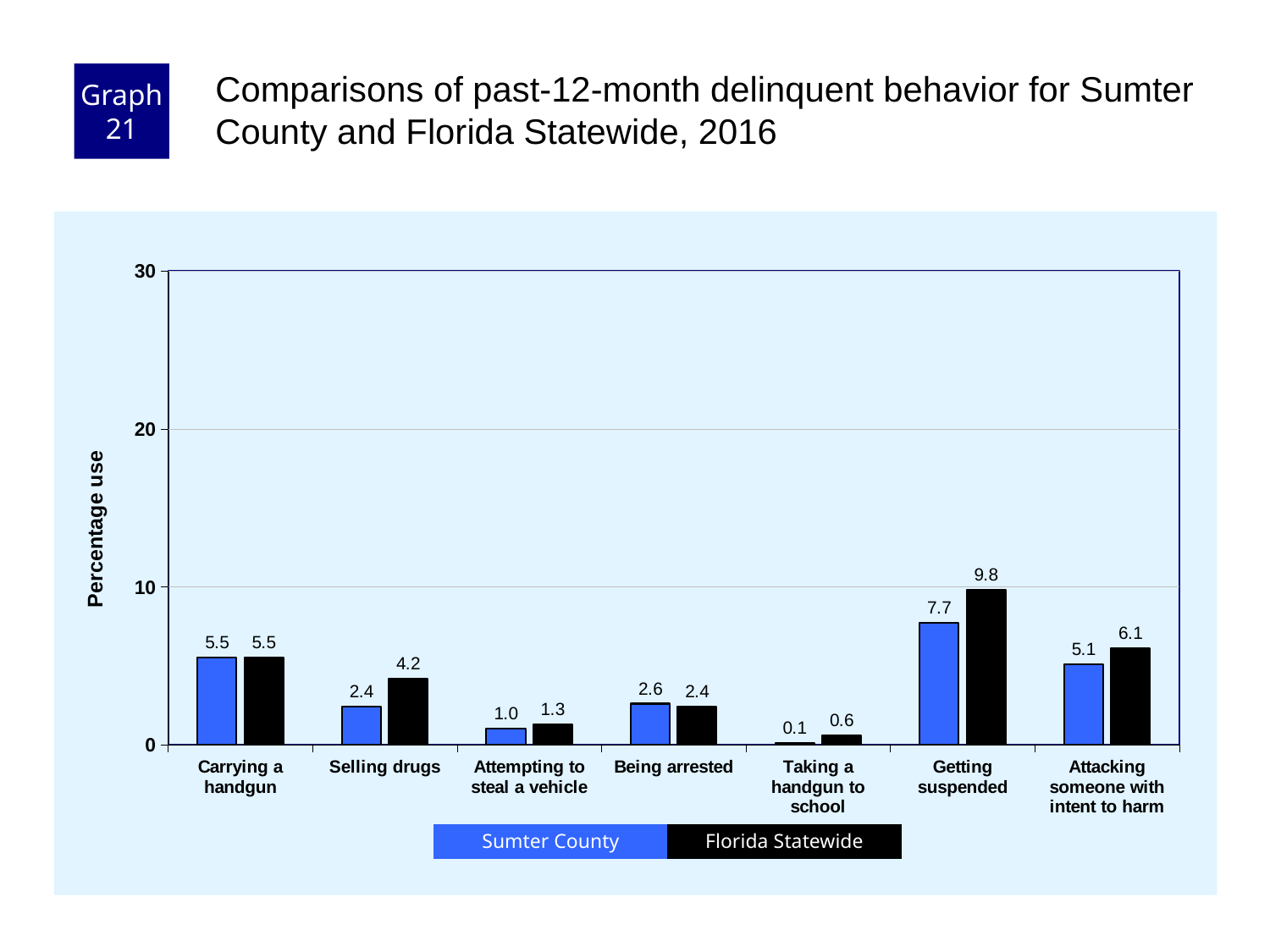
What is the label of the y axis? Percentage use Which is larger for Attacking someone with intent to harm: Sumter County or Florida Statewide? Florida Statewide How many series does the legend list? 2 What is the Florida Statewide value for Selling drugs? 4.2 What is the difference between the Florida Statewide and Sumter County values for Getting suspended? 2.1 What kind of chart is shown? bar chart Which category has the lowest Sumter County value? Taking a handgun to school How many categories are shown on the x axis? 7 What is the Sumter County value for Getting suspended? 7.7 Is the Florida Statewide value for Getting suspended greater or less than 10? less What is the Sumter County value for Taking a handgun to school? 0.1 Which category has the highest Florida Statewide value? Getting suspended